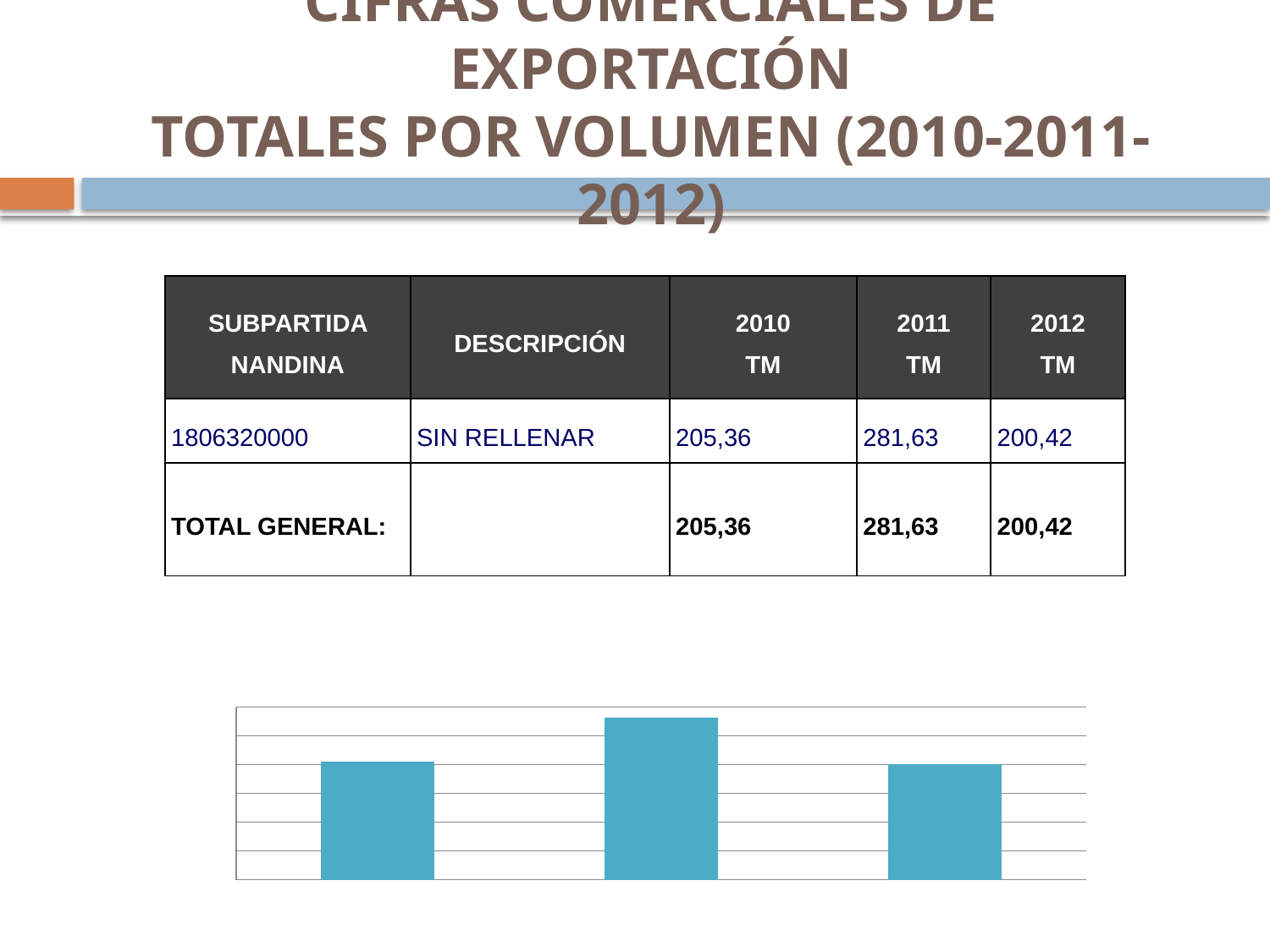
Which bar in the chart at the bottom of the slide is the tallest: the left, middle or right one? middle What colour are the bars in the chart at the bottom of the slide? blue Is the middle bar in the chart taller or shorter than the left bar? taller How many bars does the chart at the bottom of the slide have? 3 What kind of chart is shown at the bottom of the slide? bar chart Is the right bar in the chart taller or shorter than the middle bar? shorter Do the bars in the chart rise steadily from left to right? No Does the chart at the bottom of the slide show a legend? No